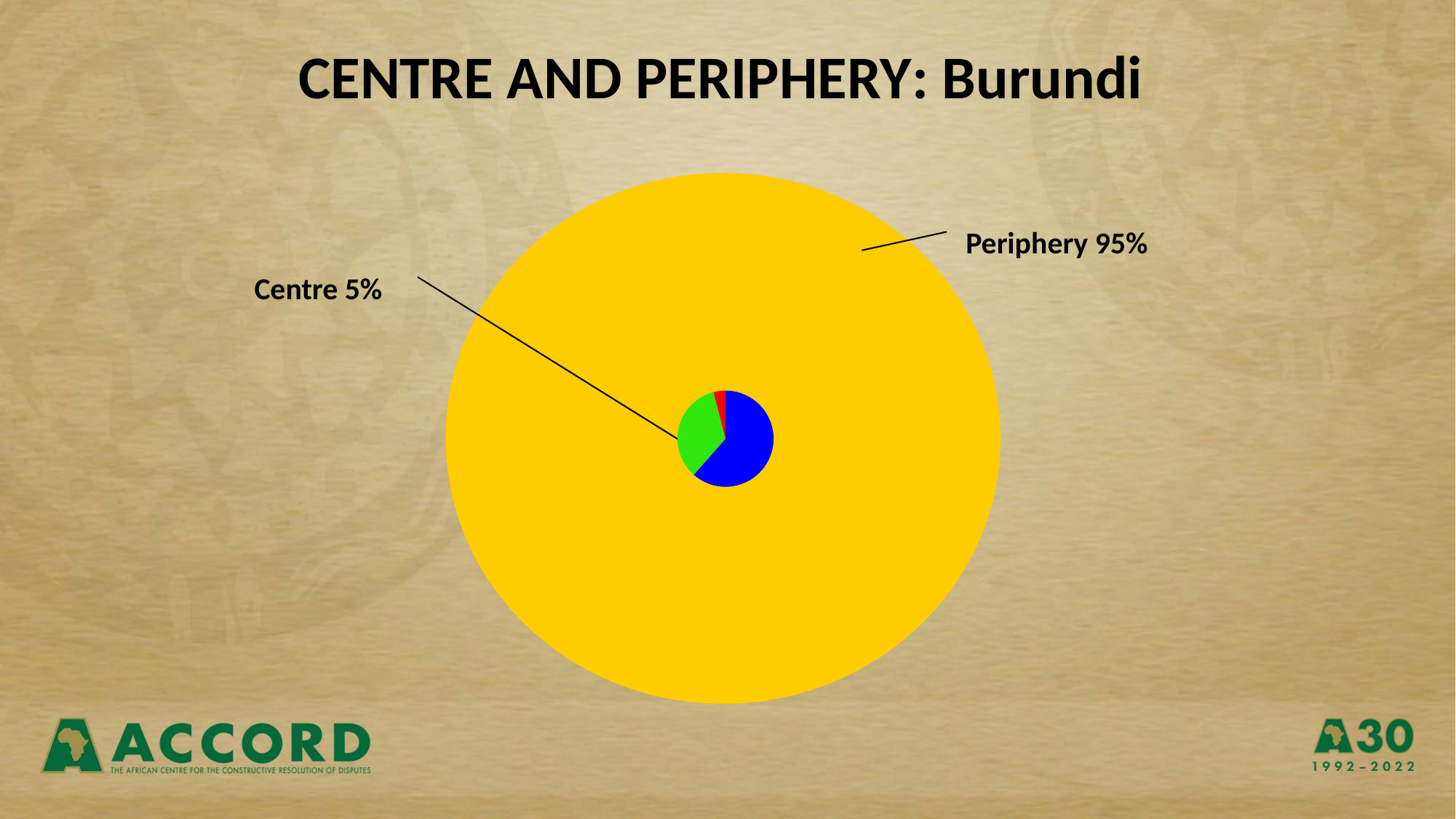
Which has the larger share, Centre or Periphery? Periphery What colour is the Periphery area of the diagram? Yellow What percentage is shown for the Periphery? 95% What is the difference in percentage points between the Periphery and the Centre? 90 What is the title of the slide? CENTRE AND PERIPHERY: Burundi What percentage is shown for the Centre? 5% What is the combined percentage of the Centre and the Periphery? 100% Which labelled part has the largest share? Periphery Which labelled part has the smallest share? Centre How many labelled parts does the diagram have? 2